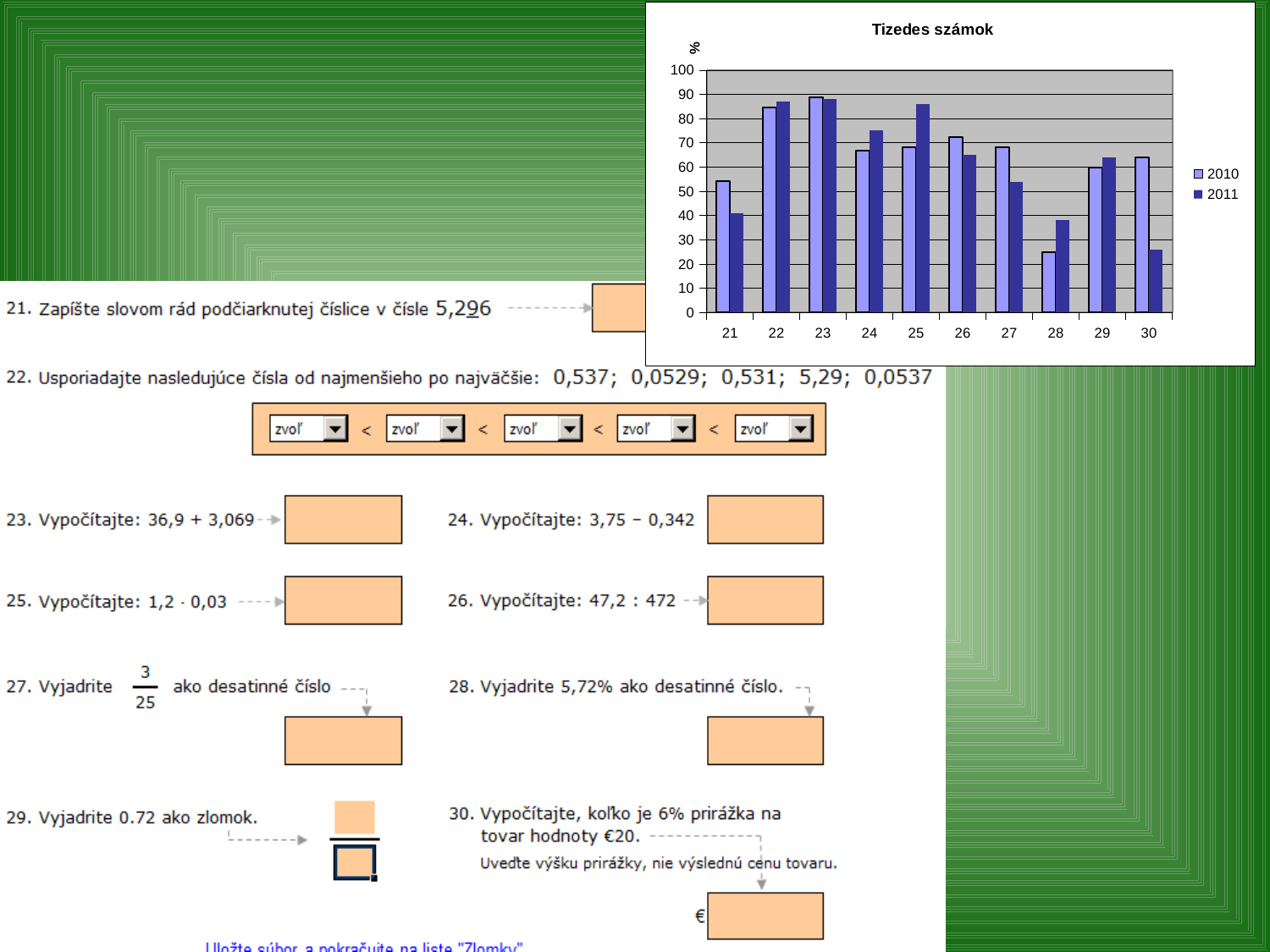
For category 21, which series has the larger value, 2010 or 2011? 2010 Is the 2011 value for category 25 greater or less than 80? greater Is the 2011 value for category 21 greater or less than 50? less Is the 2010 value for category 28 greater or less than 30? less How many categories are shown on the x axis of the chart? 10 Which category has the lowest value for the 2011 series? 30 What is the title of the chart? Tizedes számok What kind of chart is shown on the slide? bar chart For category 30, which series has the larger value, 2010 or 2011? 2010 How many series does the chart legend list? 2 Which category has the lowest value for the 2010 series? 28 For category 25, which series has the larger value, 2010 or 2011? 2011